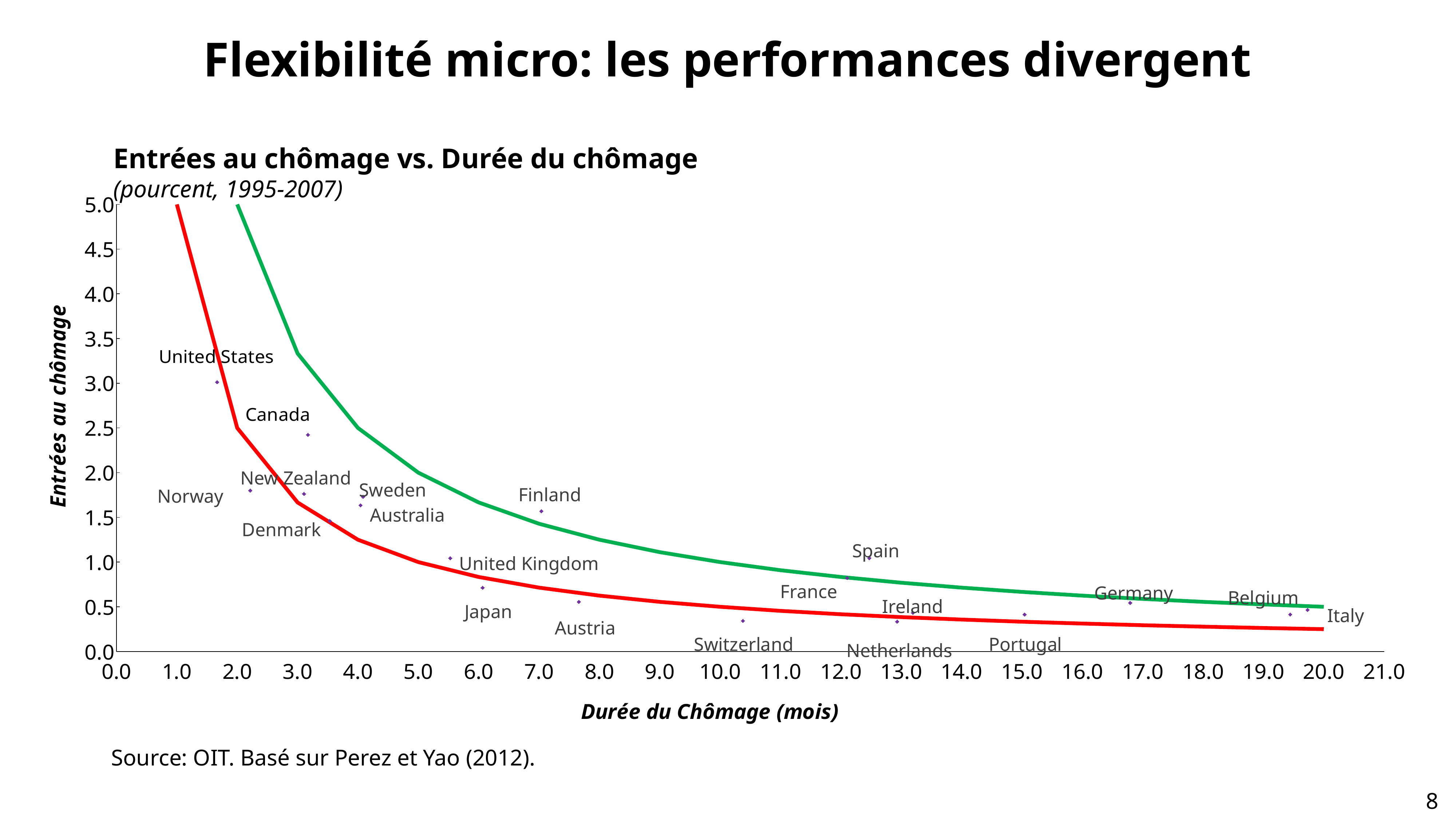
Is the Entrées au chômage value for Japan greater or less than 1.0? less What kind of chart is shown on the slide? scatter chart Is the Durée du Chômage value for Germany greater or less than 15.0? greater Which has a longer Durée du Chômage, Spain or Switzerland? Spain How many countries are labelled on the chart? 20 Which country has the highest value for Entrées au chômage? United States Is the Entrées au chômage value for United States greater or less than 2.5? greater What is the title of the chart? Entrées au chômage vs. Durée du chômage Which has a higher Entrées au chômage value, Finland or United Kingdom? Finland What is the label of the x axis? Durée du Chômage (mois)